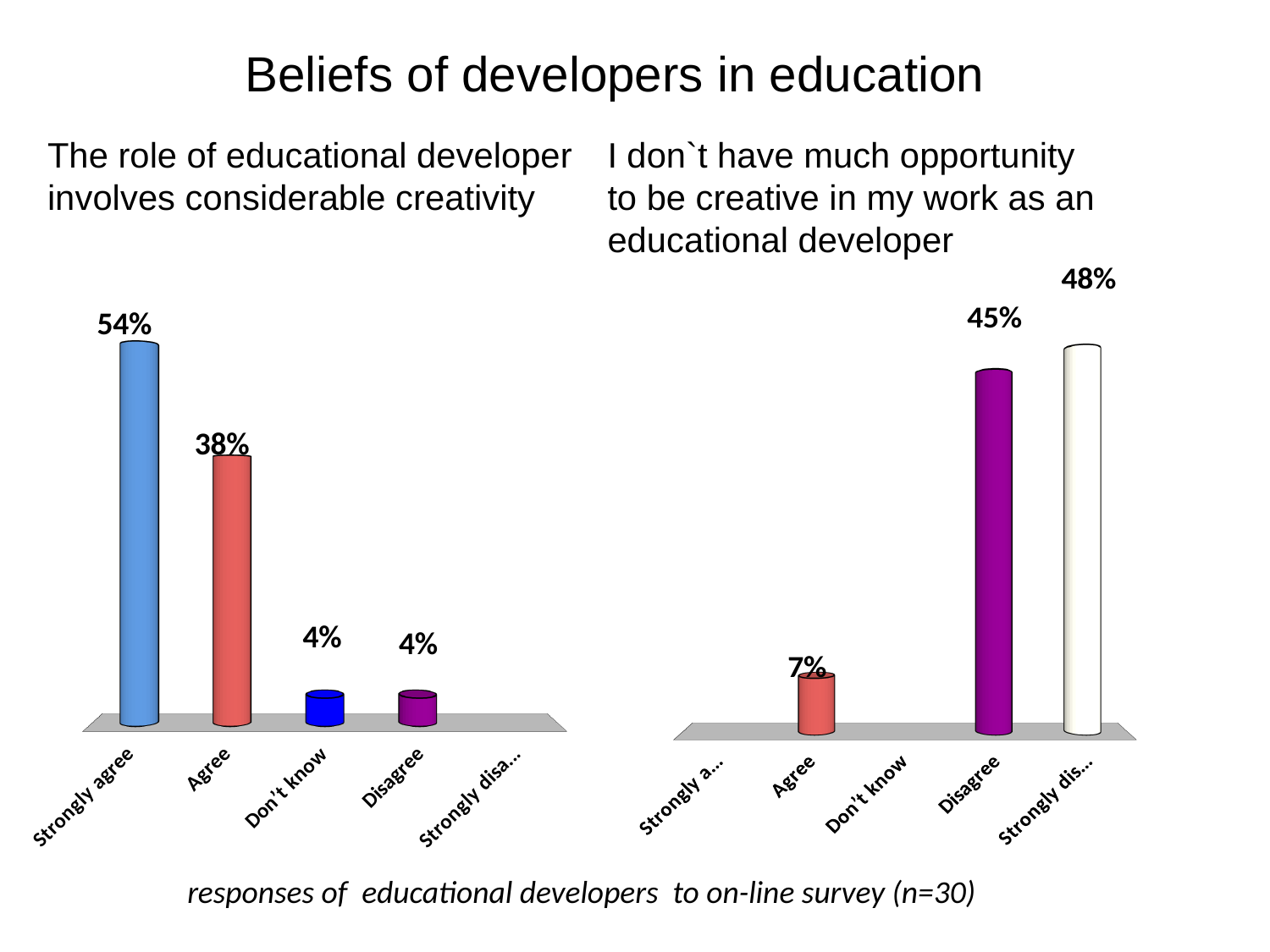
On the left chart (The role of educational developer involves considerable creativity), which category has the highest value? Strongly agree On the right chart (I don't have much opportunity to be creative in my work as an educational developer), what is the highest value shown? 48% How many categories are shown on the x axis of the left chart (The role of educational developer involves considerable creativity)? 5 On the left chart (The role of educational developer involves considerable creativity), what percentage of respondents chose Strongly agree? 54% On the left chart (The role of educational developer involves considerable creativity), what is the value for Agree? 38% On the right chart (I don't have much opportunity to be creative in my work as an educational developer), what is the difference between the Disagree value and the Agree value? 38% On the right chart (I don't have much opportunity to be creative in my work as an educational developer), what is the value for Disagree? 45% What kind of chart is used on the left side of the slide? Bar chart On the left chart (The role of educational developer involves considerable creativity), what is the difference between the Strongly agree and Agree values? 16% On the right chart (I don't have much opportunity to be creative in my work as an educational developer), what is the value for Agree? 7% On the left chart (The role of educational developer involves considerable creativity), what is the value for Disagree? 4% On the right chart (I don't have much opportunity to be creative in my work as an educational developer), which is larger, the value for Agree or the value for Disagree? Disagree